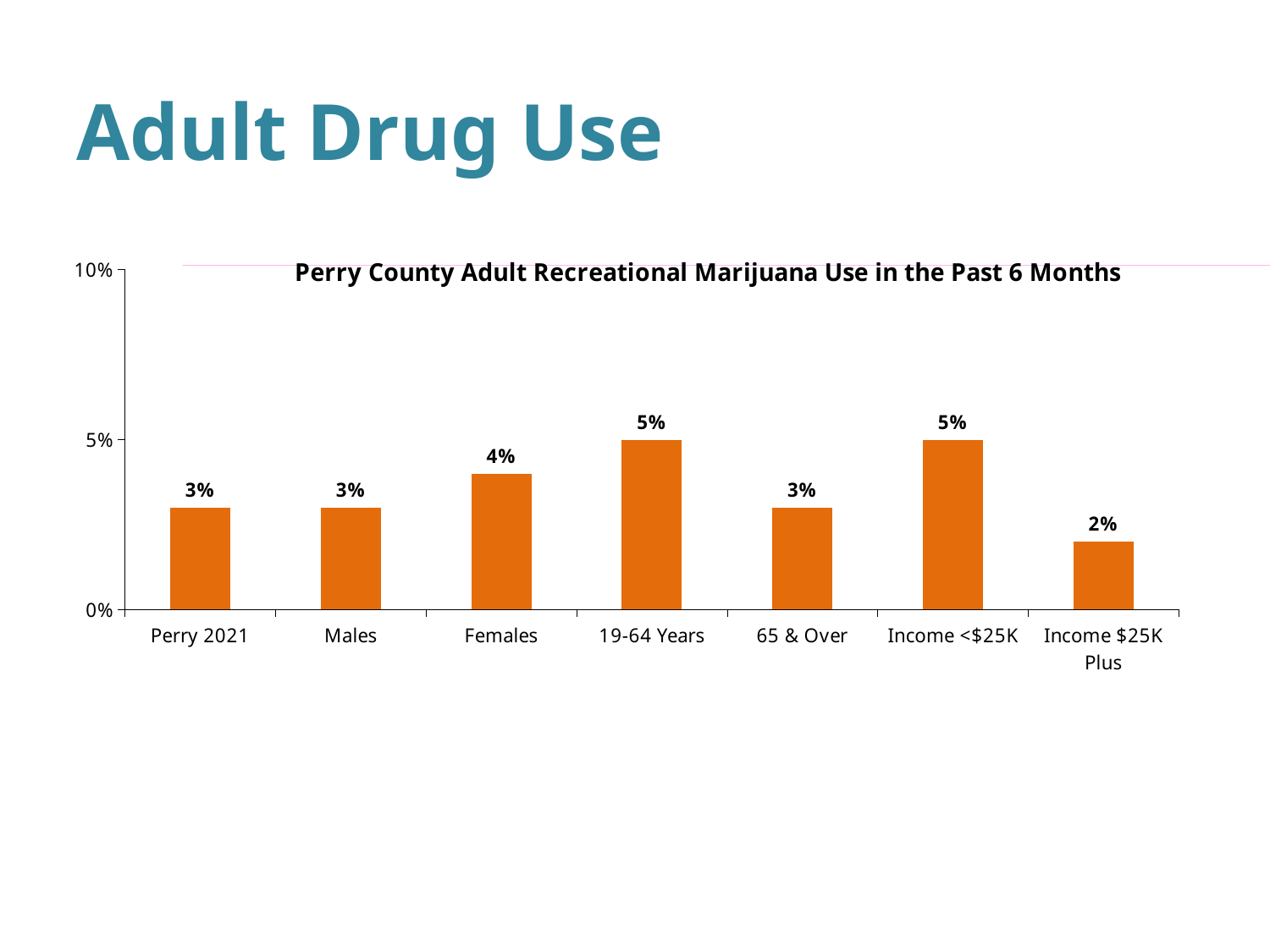
Which is larger, the value for 19-64 Years or the value for 65 & Over? 19-64 Years What is the value for Income $25K Plus? 2% What is the value for Females? 4% What is the difference between the values for Females and Males? 1% What kind of chart is shown on the slide? bar chart What is the value for 65 & Over? 3% What is the difference between the values for Income <$25K and Income $25K Plus? 3% Is the value for Females greater or less than 5%? less How many categories are shown on the x axis? 7 Which category has the lowest value? Income $25K Plus What is the value for Perry 2021? 3% What is the title of the chart? Perry County Adult Recreational Marijuana Use in the Past 6 Months